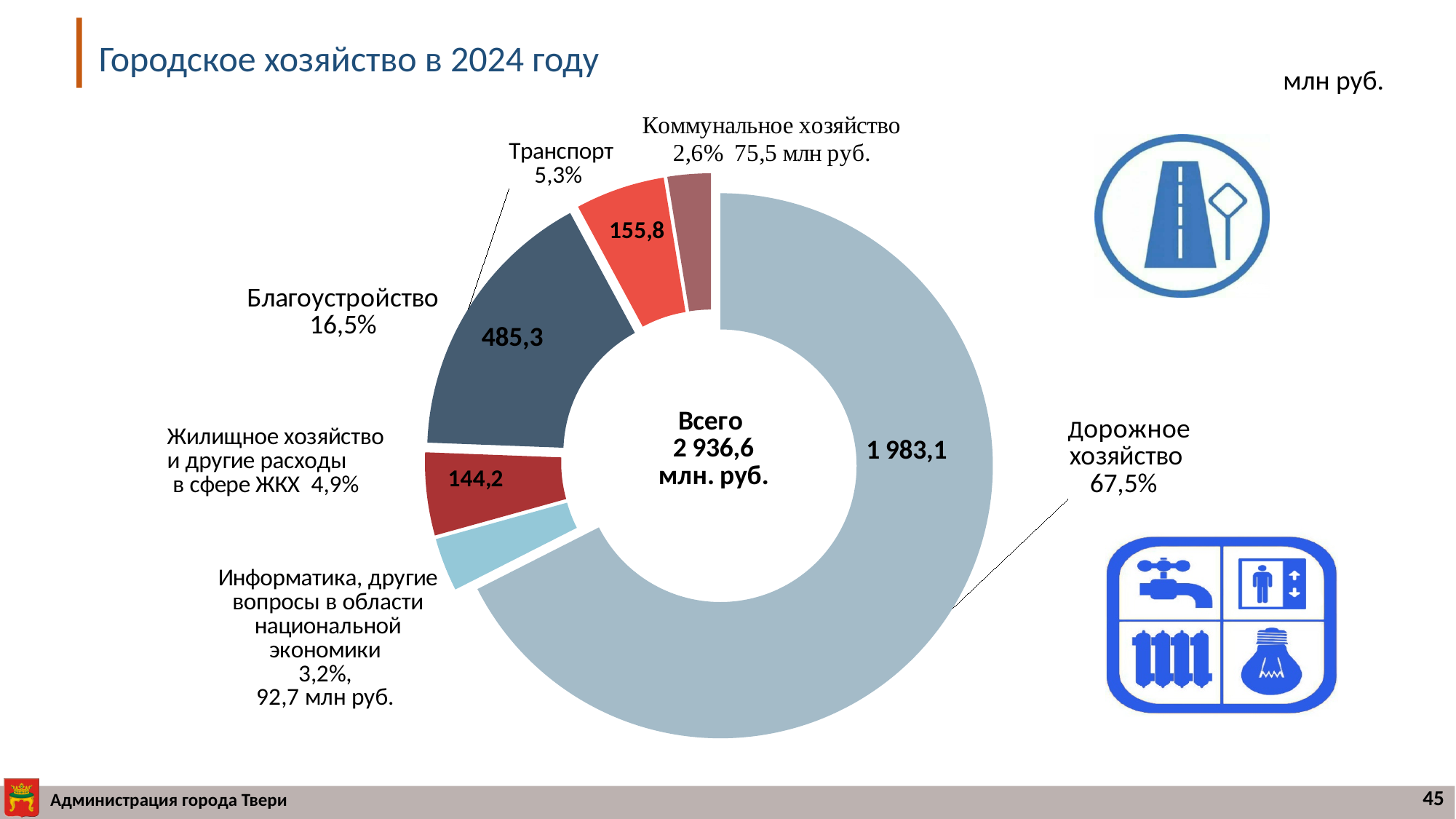
What is the total shown in the centre of the donut chart? 2 936,6 млн. руб. What is the value for Коммунальное хозяйство? 75,5 млн руб. How many categories does the donut chart show? 6 Which category has the largest value? Дорожное хозяйство Which is larger: Транспорт or Жилищное хозяйство и другие расходы в сфере ЖКХ? Транспорт What share of the total does Благоустройство account for? 16,5% What kind of chart is shown on the slide? Donut (pie) chart What share of the total does Информатика, другие вопросы в области национальной экономики account for? 3,2% What is the value for Дорожное хозяйство? 1 983,1 Which category has the smallest value? Коммунальное хозяйство What is the value for Транспорт? 155,8 What is the value for Благоустройство? 485,3